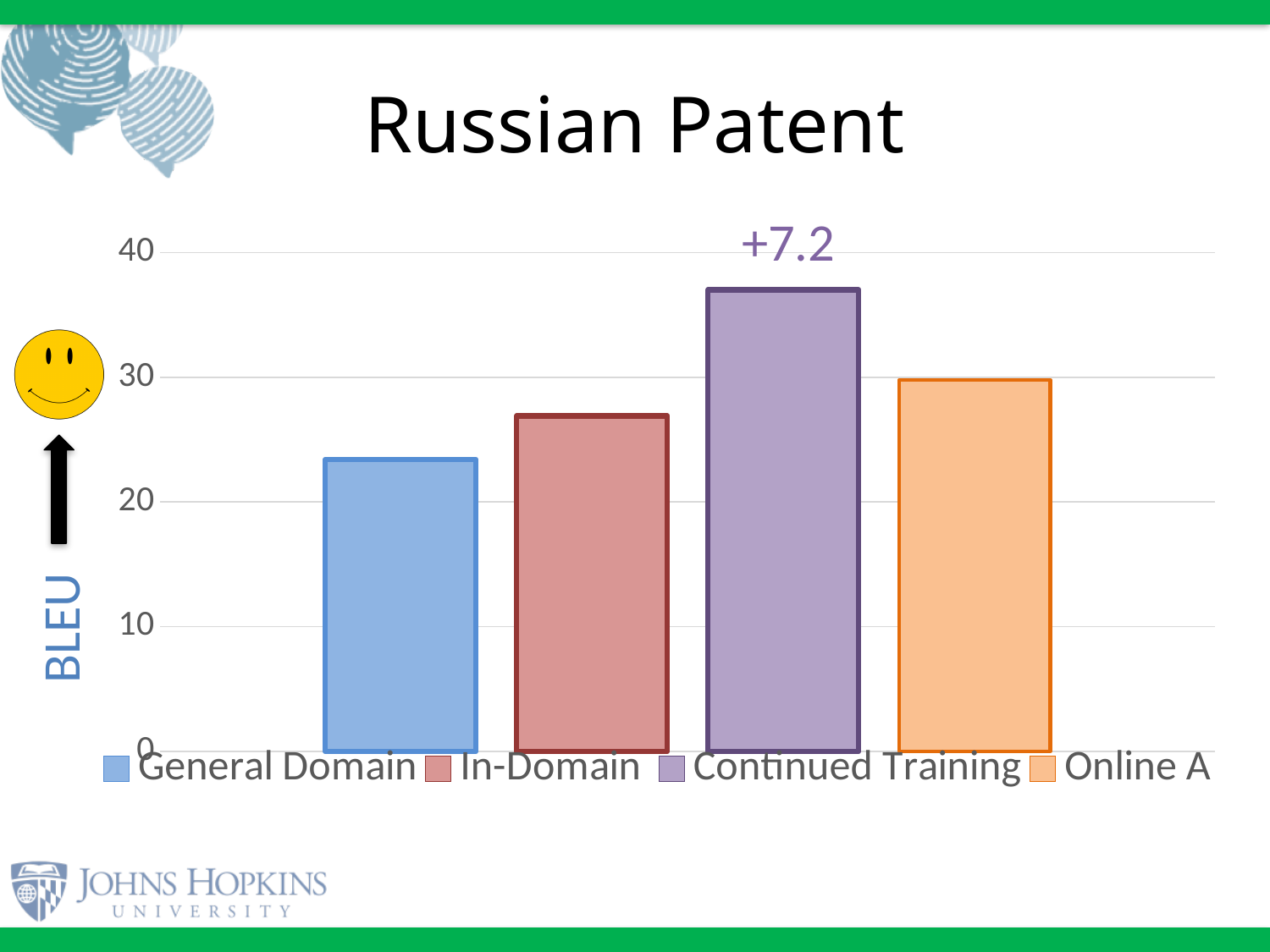
Which system has the lowest BLEU score? General Domain How many entries does the legend list? 4 Which system has the highest BLEU score? Continued Training What is the title of the chart? Russian Patent What kind of chart is shown on the slide? bar chart Is the BLEU value for In-Domain greater or less than 30? less Is the BLEU value for General Domain greater or less than 20? greater Which has a higher BLEU score, In-Domain or Online A? Online A Is the BLEU value for Continued Training greater or less than 30? greater Which has a higher BLEU score, General Domain or In-Domain? In-Domain What is the label on the vertical axis? BLEU How many bars are plotted in the chart? 4